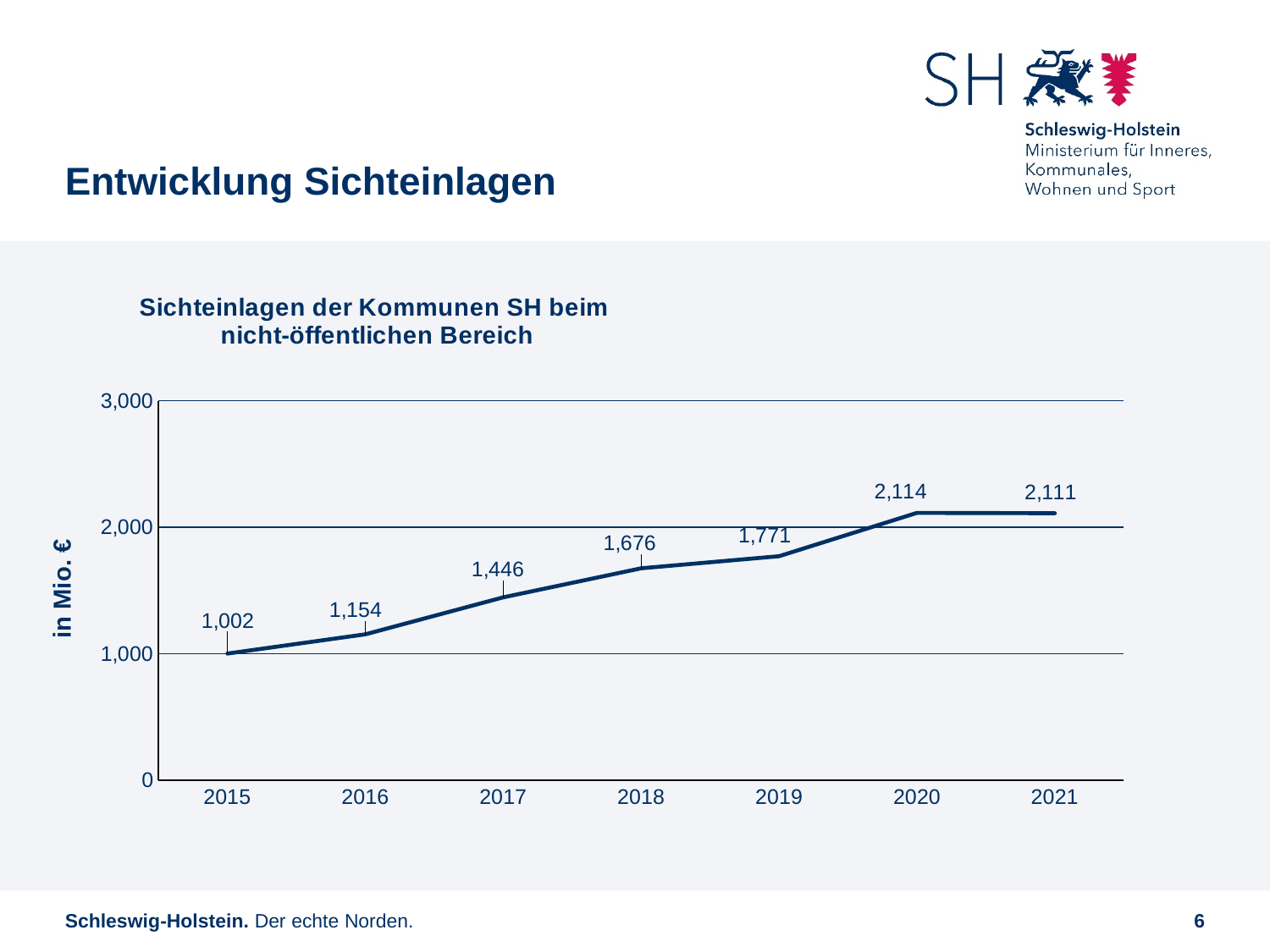
Which year has the lowest value? 2015 What is the difference between the values for 2020 and 2019? 343 What is the difference between the values for 2017 and 2016? 292 What is the value for 2018? 1,676 Which is larger, the value for 2019 or the value for 2018? 2019 What is the value for 2021? 2,111 How many years are plotted on the chart? 7 What kind of chart is shown? line chart Is the value for 2019 greater or less than 2,000? less What is the label on the vertical axis? in Mio. € Which year has the highest value? 2020 What is the value for 2015? 1,002